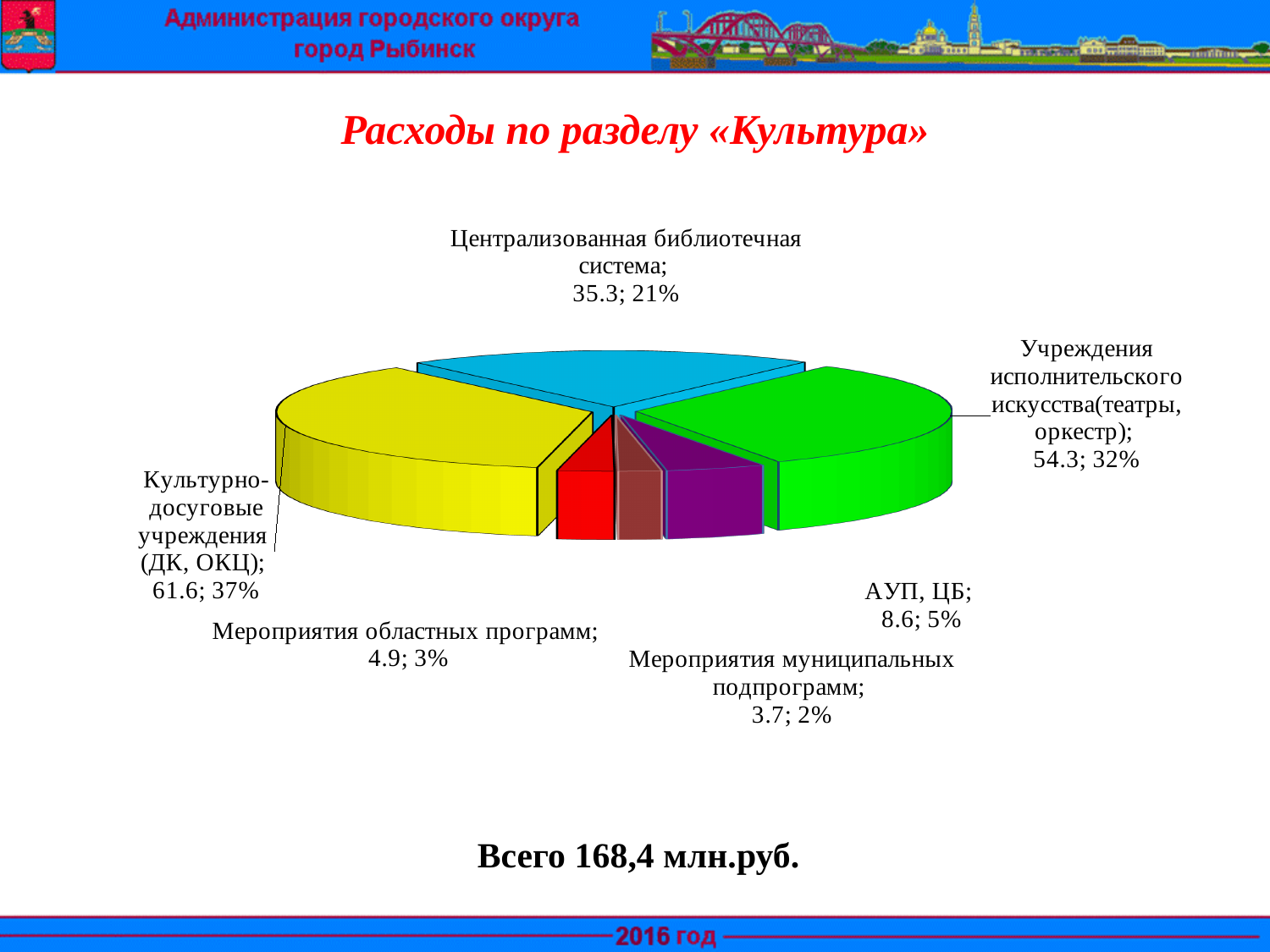
What kind of chart is shown on the slide? pie chart Which is larger: the value for «Мероприятия областных программ» or for «Мероприятия муниципальных подпрограмм»? Мероприятия областных программ What is the value for «Централизованная библиотечная система»? 35.3 What share of the pie does «Учреждения исполнительского искусства (театры, оркестр)» take? 32% Which category has the smallest slice? Мероприятия муниципальных подпрограмм What is the difference between the values for «Культурно-досуговые учреждения (ДК, ОКЦ)» and «Учреждения исполнительского искусства (театры, оркестр)»? 7.3 What is the title of the chart on the slide? Расходы по разделу «Культура» How many slices does the pie chart have? 6 What total is stated below the chart? 168,4 млн.руб. What is the value for «АУП, ЦБ»? 8.6 What share of the pie does «Мероприятия областных программ» take? 3% Which category has the largest slice? Культурно-досуговые учреждения (ДК, ОКЦ)